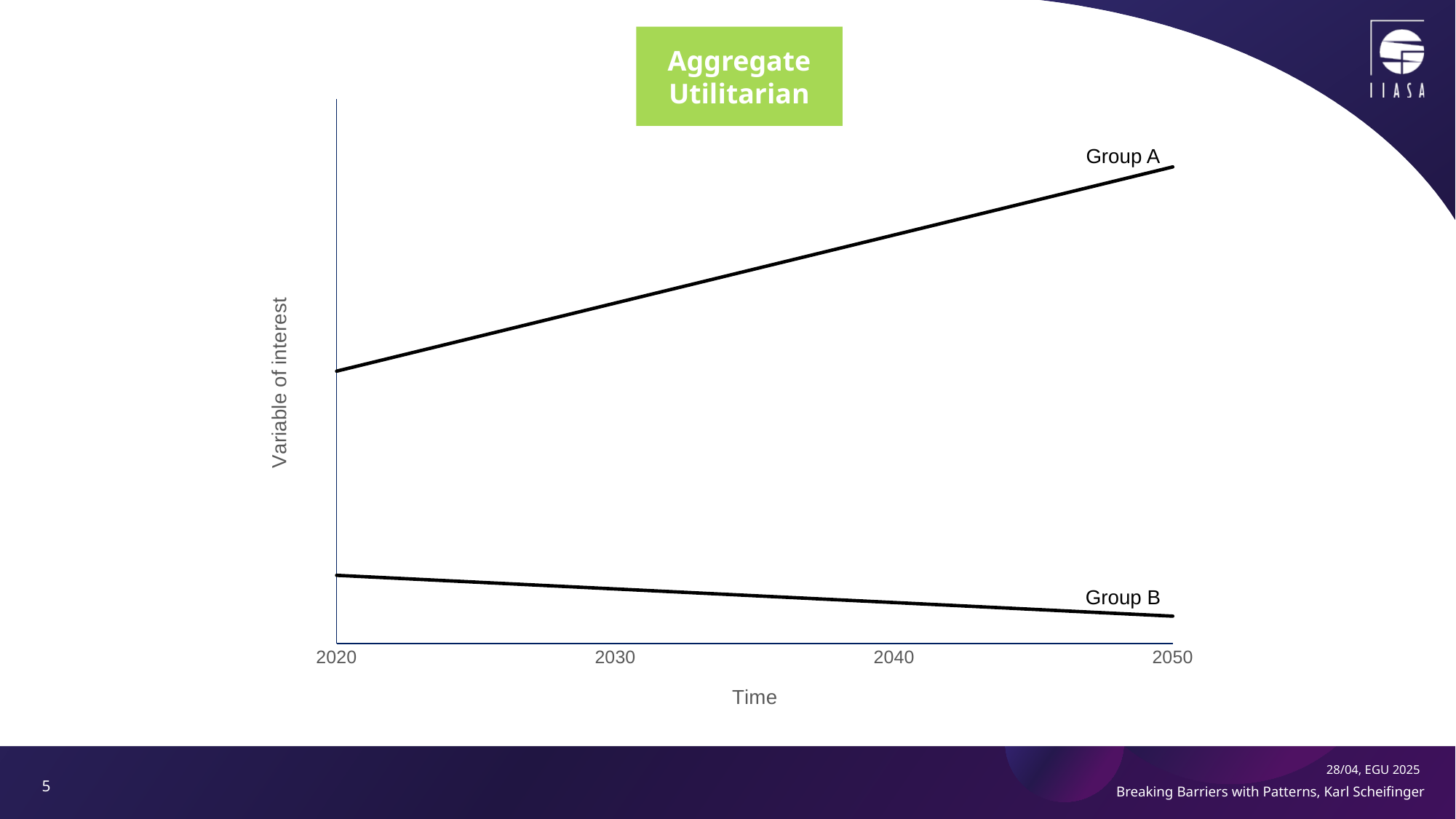
Does the Group A line rise or fall from 2020 to 2050? rise What kind of chart is shown on the slide? line chart How many lines (series) are plotted on the chart? 2 What is the last year shown on the x axis? 2050 What is the first year shown on the x axis? 2020 How many year labels are shown on the x axis? 4 What is the label of the y axis? Variable of interest Which line is lowest on the chart across the whole time range? Group B Which group has the higher value in 2050, Group A or Group B? Group A Which group has the higher value in 2020, Group A or Group B? Group A Does the Group B line rise or fall from 2020 to 2050? fall What is the title shown above the chart? Aggregate Utilitarian